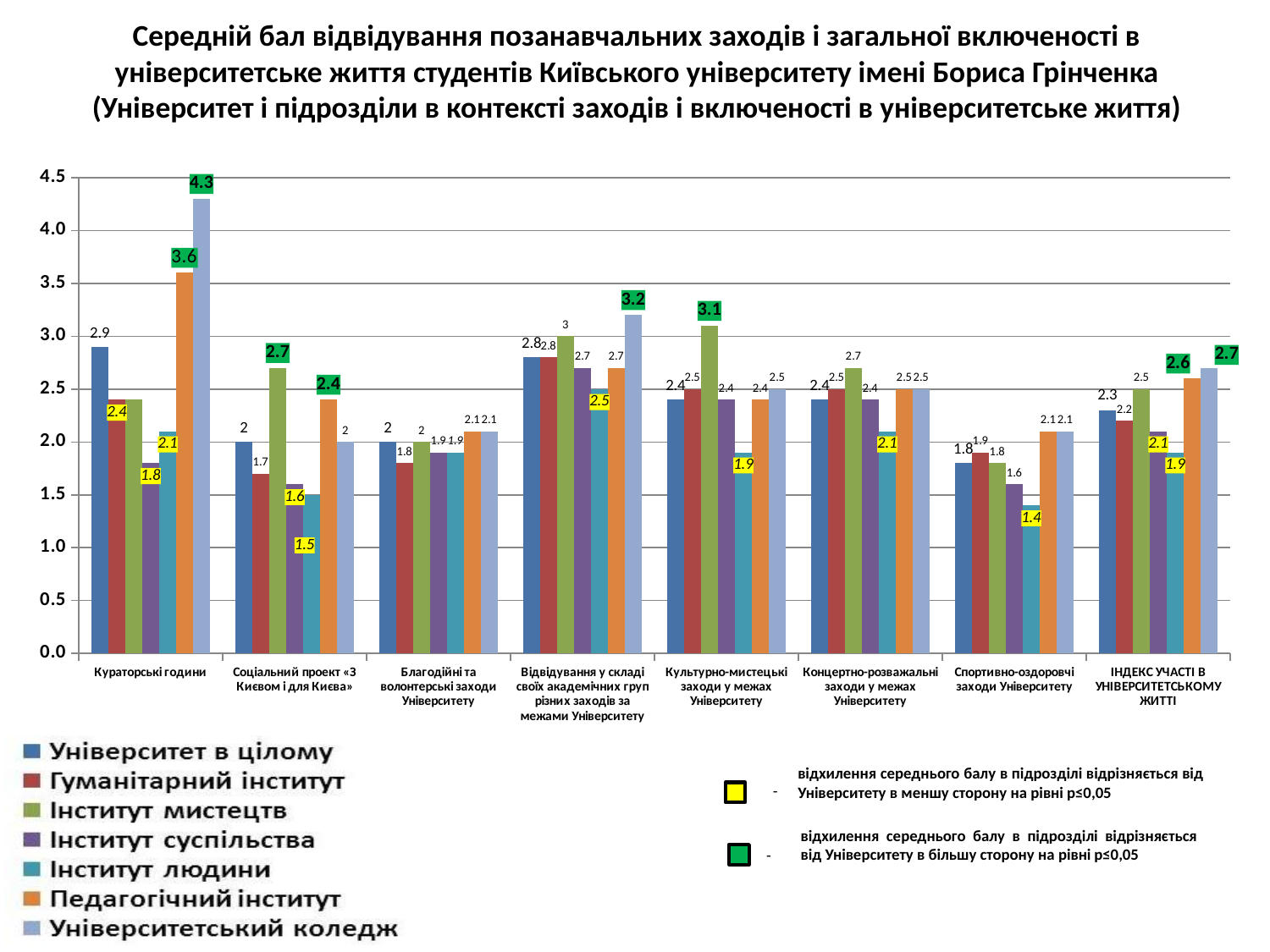
What does the green marker in the note below the chart indicate? Deviation of the unit's mean score from the University upward at p≤0,05 Which series has the lowest value in the category Соціальний проект «З Києвом і для Києва»? Інститут людини What is the difference between the values for Педагогічний інститут and Університет в цілому in the category Кураторські години? 0.7 In the category ІНДЕКС УЧАСТІ В УНІВЕРСИТЕТСЬКОМУ ЖИТТІ, which is larger: the value for Університетський коледж or the value for Інститут людини? Університетський коледж What is the value for Інститут людини in the category Спортивно-оздоровчі заходи Університету? 1.4 Is the value for Університетський коледж in the category Відвідування у складі своїх академічних груп різних заходів за межами Університету greater or less than 3.0? greater What type of chart is shown on the slide? Bar chart How many categories are shown along the x axis? 8 How many series does the legend list? 7 What is the value for Інститут мистецтв in the category Культурно-мистецькі заходи у межах Університету? 3.1 What is the value for Університетський коледж in the category Кураторські години? 4.3 Which series has the highest value in the category Кураторські години? Університетський коледж